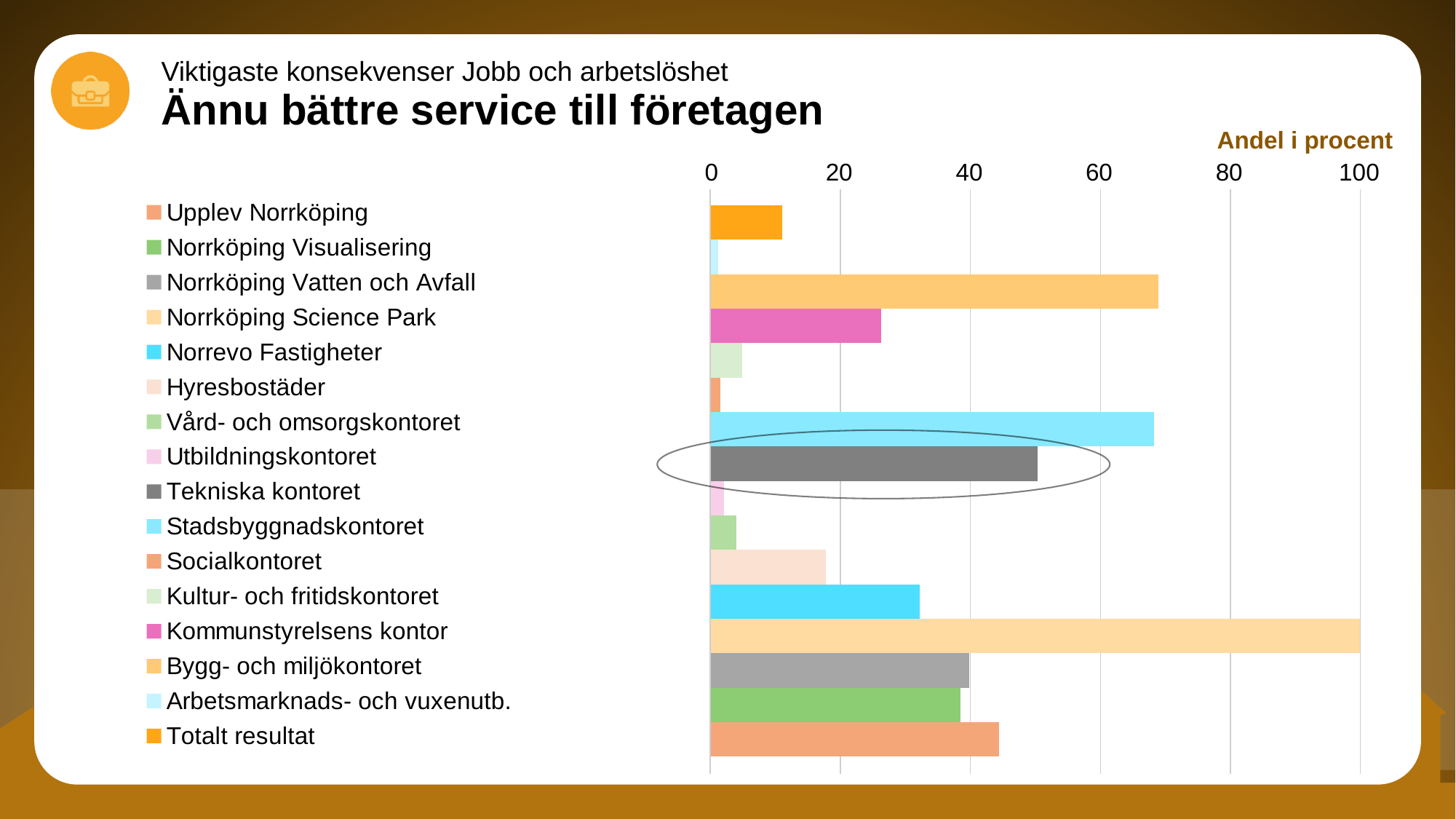
How many entries does the legend list? 16 Is the value for Bygg- och miljökontoret greater or less than 60? greater Is the value for Stadsbyggnadskontoret greater or less than 60? greater Which is larger, the value for Kommunstyrelsens kontor or the value for Hyresbostäder? Kommunstyrelsens kontor Is the value for Norrevo Fastigheter greater or less than 40? less What kind of chart is shown on the slide? bar chart Which category has the highest value in the chart? Norrköping Science Park Which is larger, the value for Tekniska kontoret or the value for Norrevo Fastigheter? Tekniska kontoret What label is shown above the horizontal axis of the chart? Andel i procent